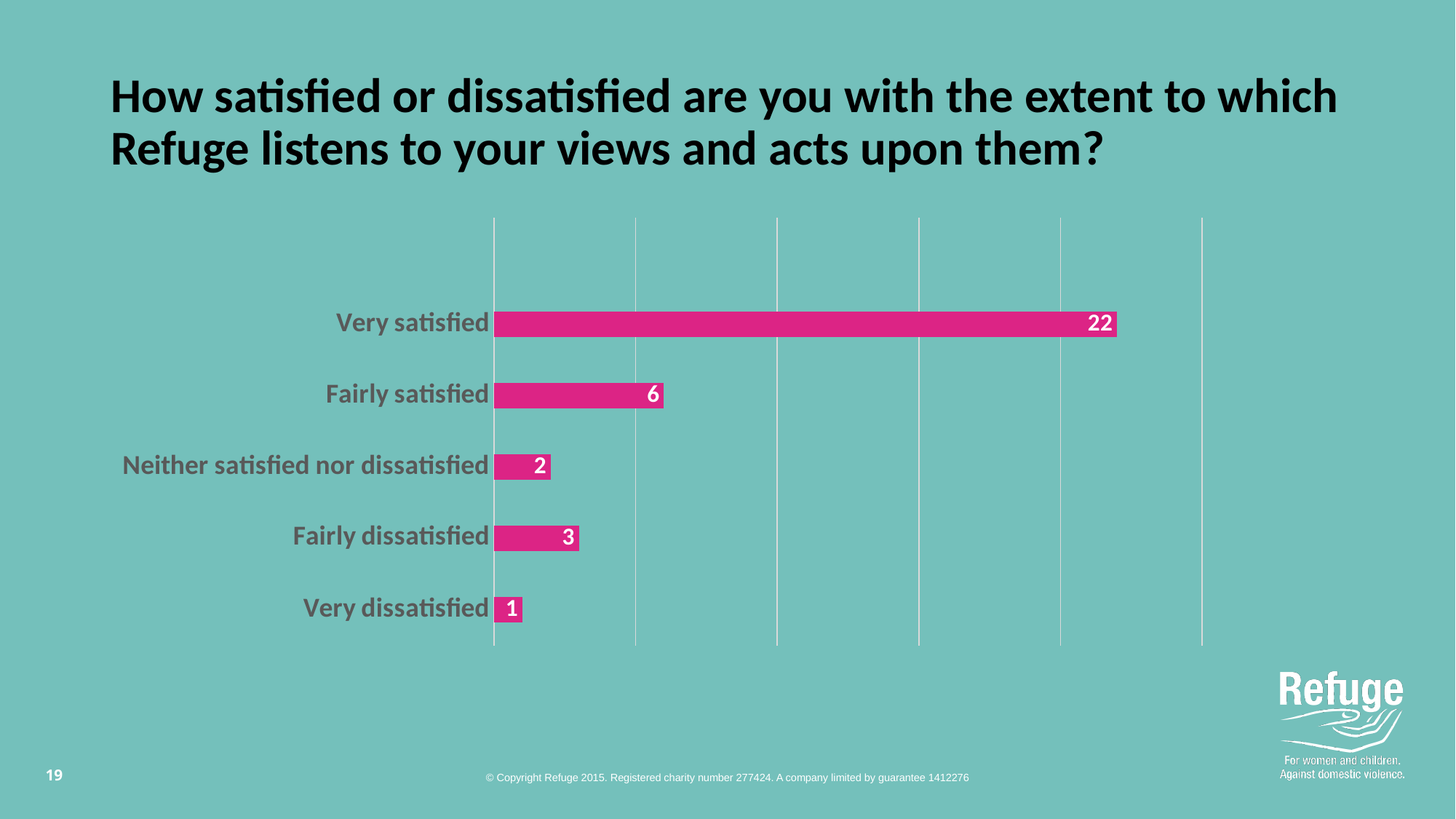
What is the value for Neither satisfied nor dissatisfied? 2 Which category has the lowest value? Very dissatisfied What is the value for Very satisfied? 22 Which category has the highest value? Very satisfied What is the value for Fairly satisfied? 6 What is the value for Fairly dissatisfied? 3 How many categories are shown in the chart? 5 What colour are the bars in the chart? Pink What kind of chart is shown on the slide? Bar chart What is the value for Very dissatisfied? 1 Which is larger, the value for Fairly dissatisfied or the value for Neither satisfied nor dissatisfied? Fairly dissatisfied What is the difference between the values for Very satisfied and Fairly satisfied? 16